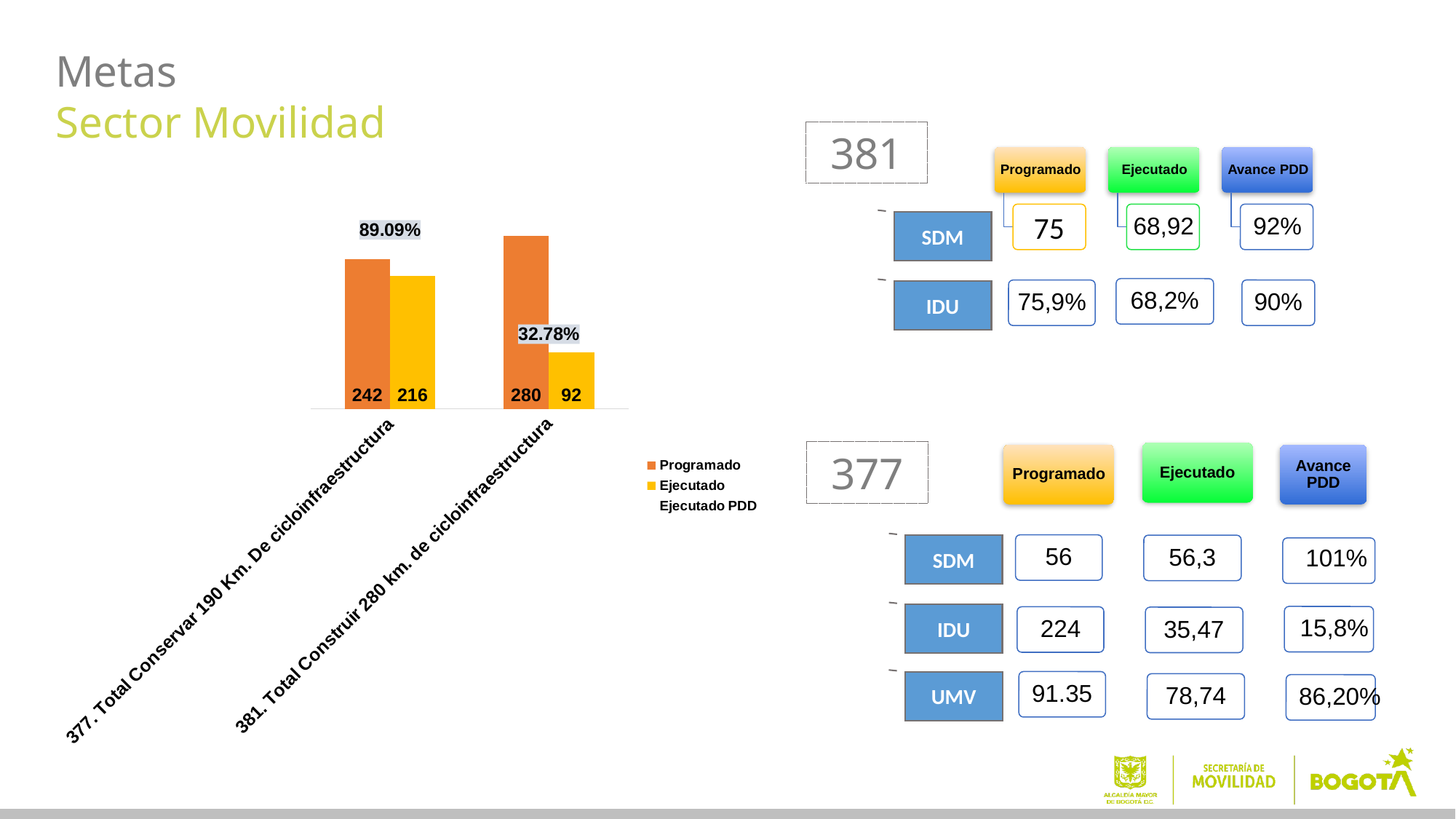
What is the Ejecutado value for '381. Total Construir 280 km. de cicloinfraestructura'? 92 How many categories are shown on the x axis of the chart? 2 How many series does the chart legend list? 3 What type of chart is shown on the slide? bar chart Which category has the higher Programado value? 381. Total Construir 280 km. de cicloinfraestructura Which category has the lower Ejecutado value? 381. Total Construir 280 km. de cicloinfraestructura What is the Ejecutado PDD percentage shown for '377. Total Conservar 190 Km. De cicloinfraestructura'? 89.09% What is the Programado value for '377. Total Conservar 190 Km. De cicloinfraestructura'? 242 Is the Ejecutado value larger for '377. Total Conservar 190 Km. De cicloinfraestructura' or for '381. Total Construir 280 km. de cicloinfraestructura'? 377. Total Conservar 190 Km. De cicloinfraestructura What is the Ejecutado PDD percentage shown for '381. Total Construir 280 km. de cicloinfraestructura'? 32.78% What colour are the Ejecutado bars in the chart? yellow What is the difference between the Programado and Ejecutado values for '381. Total Construir 280 km. de cicloinfraestructura'? 188